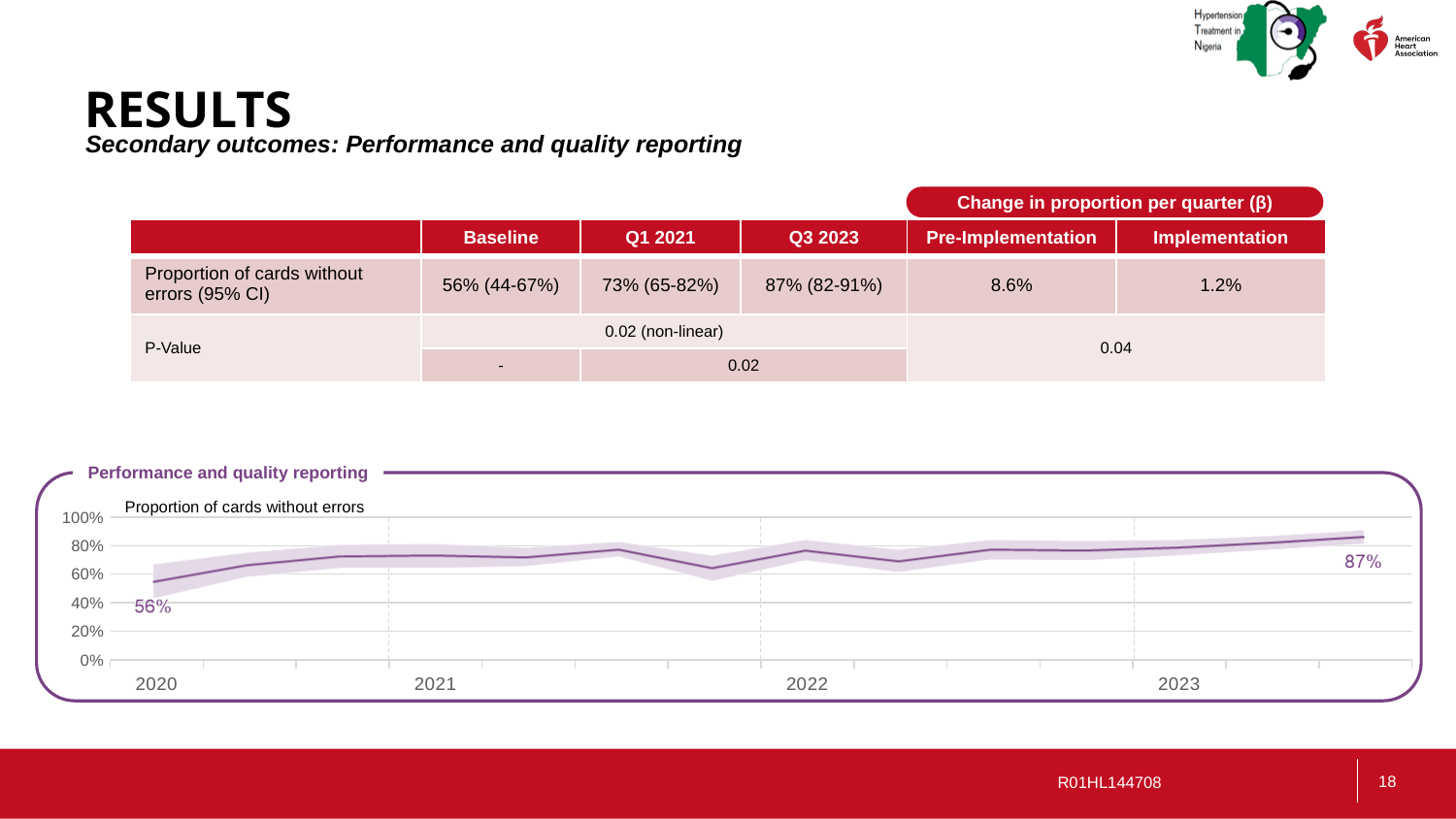
Is the value at the 2020 tick greater or less than 80%? less What type of chart is shown under "Performance and quality reporting"? line chart Which labelled value is larger, the 2020 value or the 2023 value? 2023 value (87%) By how many percentage points does the labelled end value (87%) exceed the labelled start value (56%)? 31 percentage points Does the proportion of cards without errors generally rise or fall from 2020 to 2023? rise How many year labels are shown on the x axis? 4 What is the labelled value at the start of the line in 2020? 56% What is the labelled value at the end of the line in 2023? 87% Is the value at the 2021 tick greater or less than 60%? greater What is the maximum value shown on the y axis? 100% What is the title of the chart? Proportion of cards without errors Is the value at the 2023 tick greater or less than 60%? greater